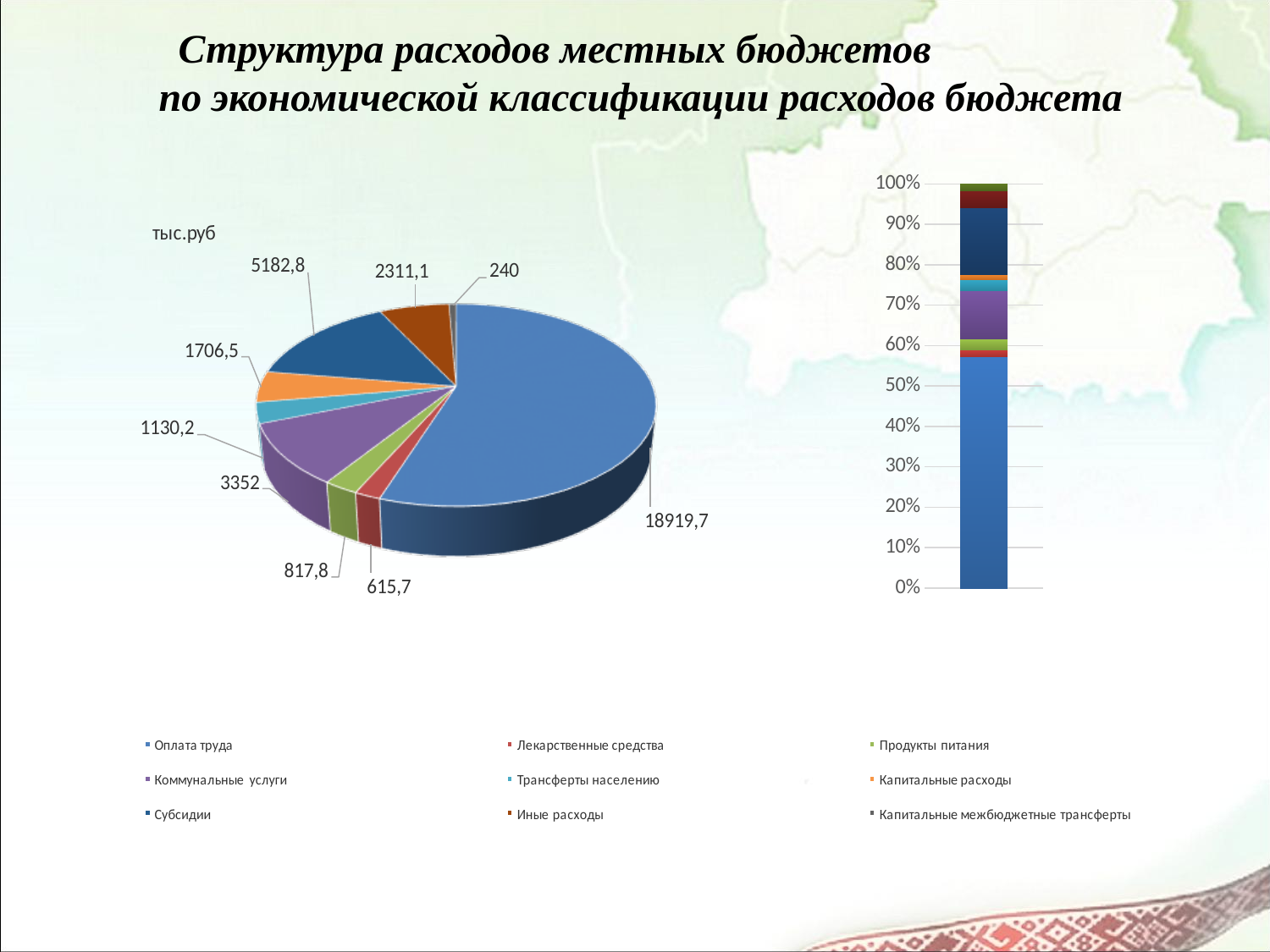
On the pie chart, what is the value for Коммунальные услуги? 3352 On the pie chart, which category has the largest value? Оплата труда On the stacked bar chart on the right, is the share for Оплата труда greater or less than 50%? greater On the pie chart, what is the difference between Субсидии and Иные расходы? 2871,7 On the pie chart, what is the value for Капитальные межбюджетные трансферты? 240 How many categories does the legend list? 9 What unit is shown above the pie chart? тыс.руб On the pie chart, which is larger: Капитальные расходы or Трансферты населению? Капитальные расходы On the pie chart, what is the value for Оплата труда? 18919,7 On the pie chart, what is the value for Субсидии? 5182,8 On the pie chart, which category has the smallest value? Капитальные межбюджетные трансферты What kind of chart is the chart on the left? Pie chart